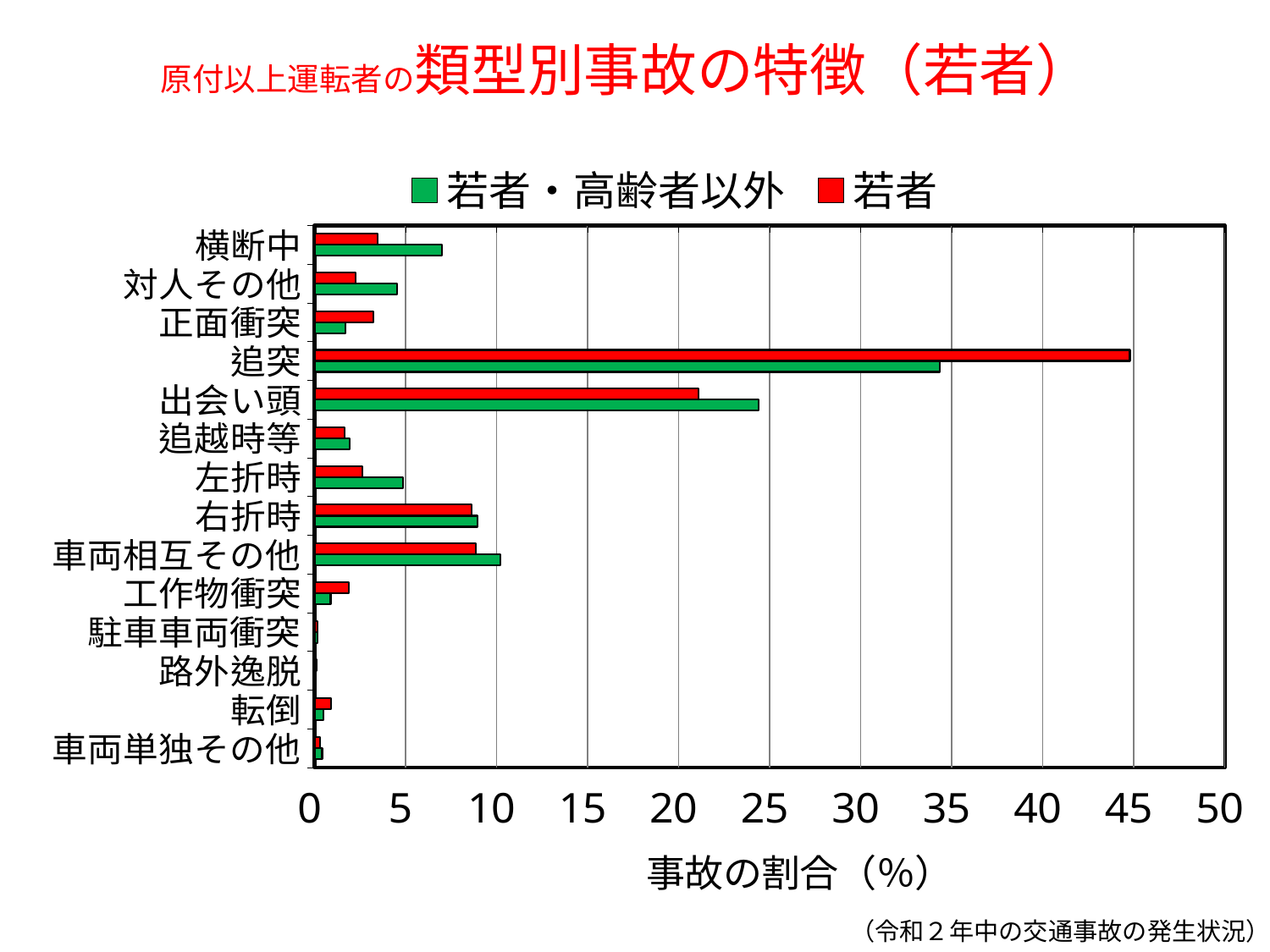
For 出会い頭, which series has the larger value, 若者 or 若者・高齢者以外? 若者・高齢者以外 Is the 若者 value for 横断中 greater or less than 5? less Is the 若者・高齢者以外 value for 出会い頭 greater or less than 20? greater Which category has the highest value for the 若者 series? 追突 What colour represents the 若者 series in the chart? red How many accident-type categories are plotted on the chart? 14 For 工作物衝突, which series has the larger value, 若者 or 若者・高齢者以外? 若者 Is the 若者・高齢者以外 value for 追突 greater or less than 30? greater How many series does the legend list? 2 Which category has the highest value for the 若者・高齢者以外 series? 追突 What kind of chart is shown on the slide? bar chart